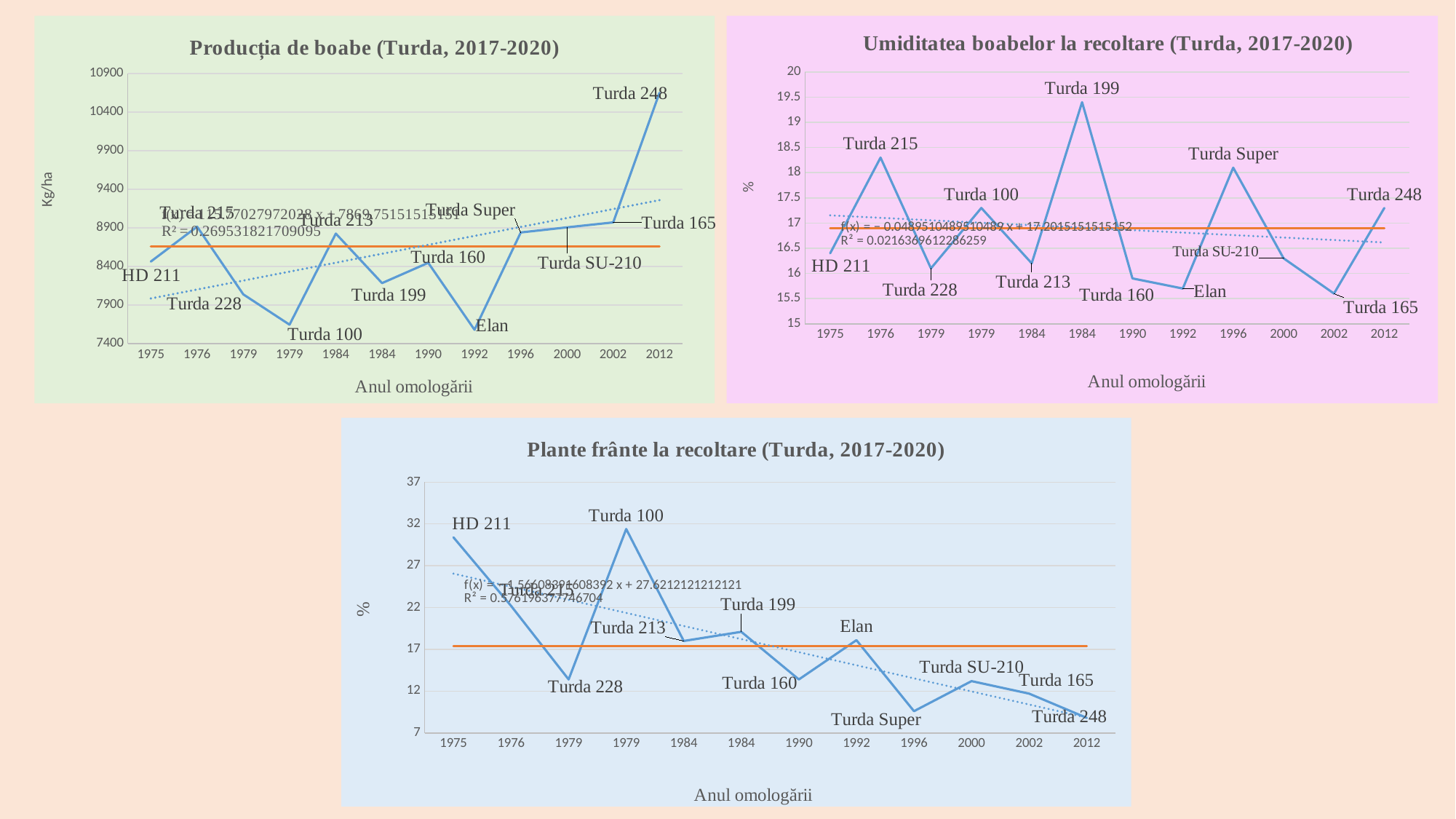
In the chart "Umiditatea boabelor la recoltare (Turda, 2017-2020)", is the value for Turda 199 greater or less than 19? greater In the chart "Umiditatea boabelor la recoltare (Turda, 2017-2020)", which variety has the highest value? Turda 199 In the chart "Umiditatea boabelor la recoltare (Turda, 2017-2020)", which is larger, the value for Turda 215 or the value for Turda 228? Turda 215 In the chart "Producția de boabe (Turda, 2017-2020)", which variety has the highest value? Turda 248 How many data points are plotted in the chart "Producția de boabe (Turda, 2017-2020)"? 12 In the chart "Plante frânte la recoltare (Turda, 2017-2020)", do the values generally rise or fall along the x axis? fall What kind of chart is "Producția de boabe (Turda, 2017-2020)"? line chart In the chart "Producția de boabe (Turda, 2017-2020)", is the value for Turda 248 greater or less than 10400? greater In the chart "Plante frânte la recoltare (Turda, 2017-2020)", is the value for Turda 228 greater or less than 17? less What is the x-axis label of the chart "Plante frânte la recoltare (Turda, 2017-2020)"? Anul omologării What is the y-axis label of the chart "Producția de boabe (Turda, 2017-2020)"? Kg/ha In the chart "Producția de boabe (Turda, 2017-2020)", which variety has the lowest value? Elan